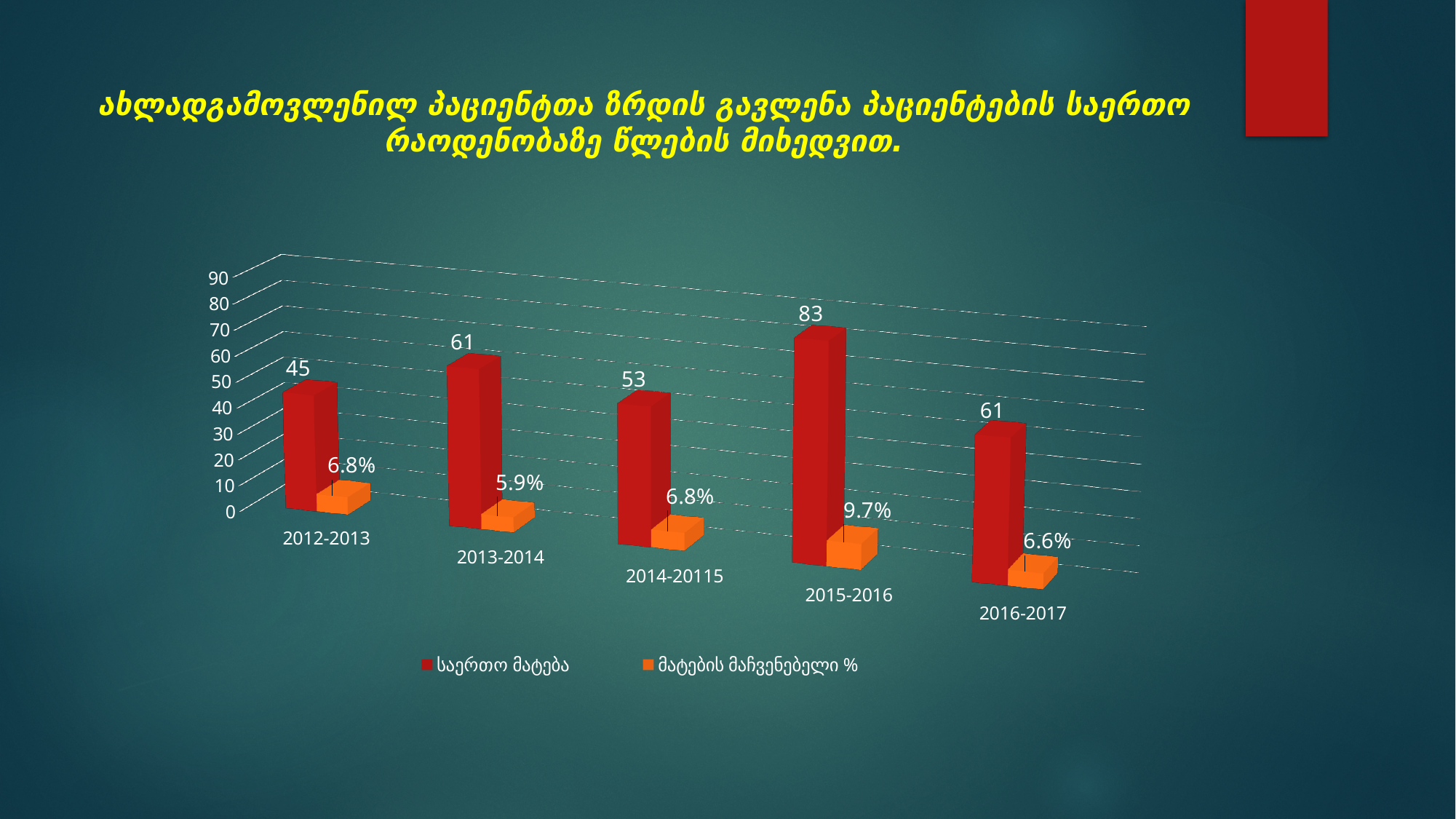
What is the difference between the red series values for 2015-2016 and 2012-2013? 38 What is the value of the orange series (მატების მაჩვენებელი %) for 2013-2014? 5.9% How many series does the legend list? 2 What is the value of the red series (საერთო მატება) for 2015-2016? 83 Which period has the lowest value for the orange series (მატების მაჩვენებელი %)? 2013-2014 What colour are the bars for the series საერთო მატება? Red What is the value of the red series (საერთო მატება) for 2012-2013? 45 What is the value of the orange series (მატების მაჩვენებელი %) for 2016-2017? 6.6% Which is larger for the red series (საერთო მატება): 2013-2014 or 2014-20115? 2013-2014 What kind of chart is shown on the slide? Bar chart Which period has the highest value for the red series (საერთო მატება)? 2015-2016 How many periods are shown on the x axis? 5